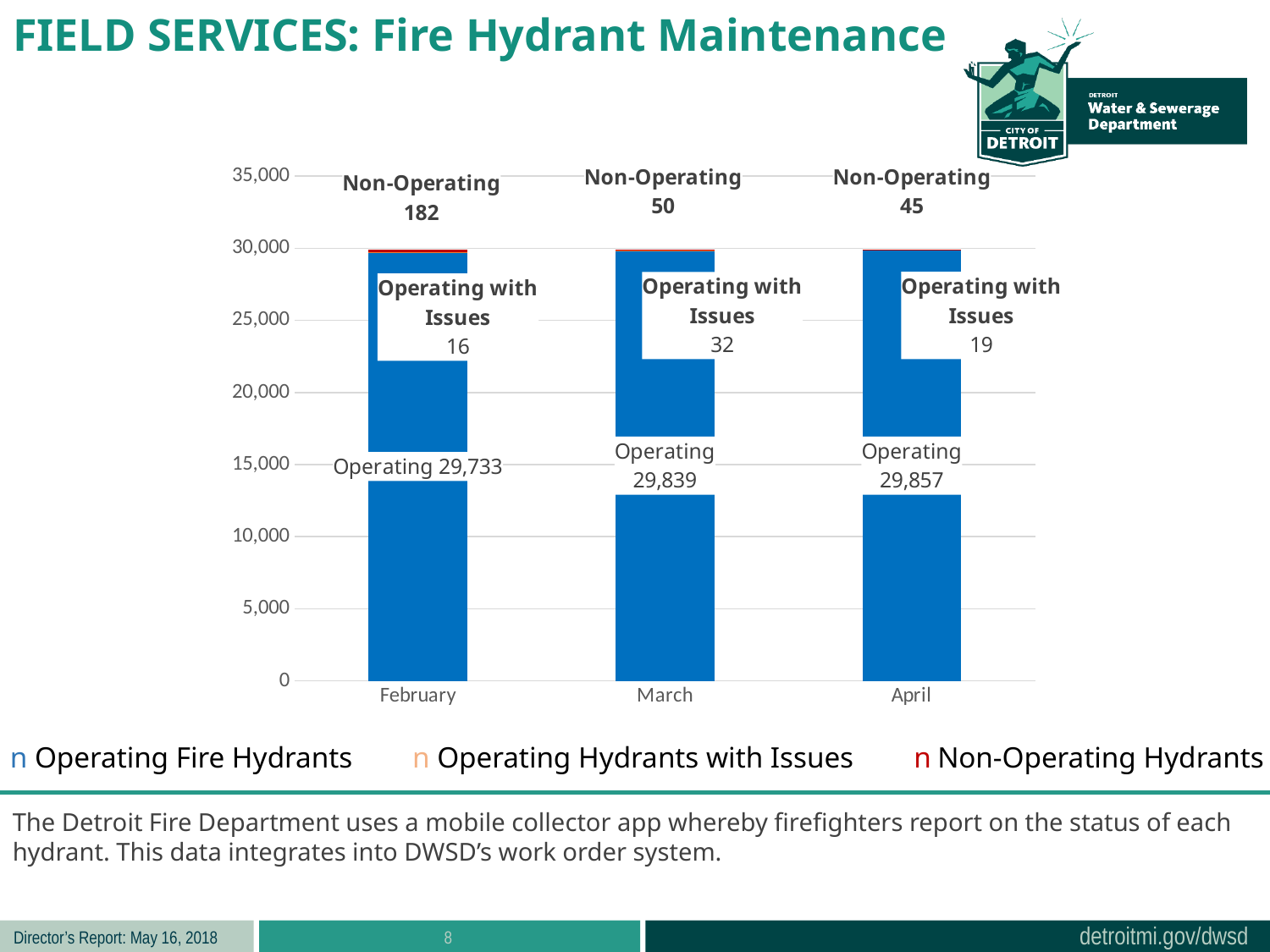
What is the number of Operating Hydrants with Issues in April? 19 What kind of chart is shown on the slide? Stacked bar chart What is the number of Operating Fire Hydrants in February? 29,733 How many months are shown on the x axis? 3 Which is larger, the number of Operating Hydrants with Issues in March or in April? March What is the total of the stacked bar for February? 29,931 How many series does the legend list? 3 What is the number of Non-Operating Hydrants in March? 50 What is the difference between the Non-Operating Hydrants in February and in April? 137 Which month has the highest number of Non-Operating Hydrants? February Which month has the lowest number of Operating Hydrants with Issues? February Do the Operating Fire Hydrants values rise or fall from February to April? Rise